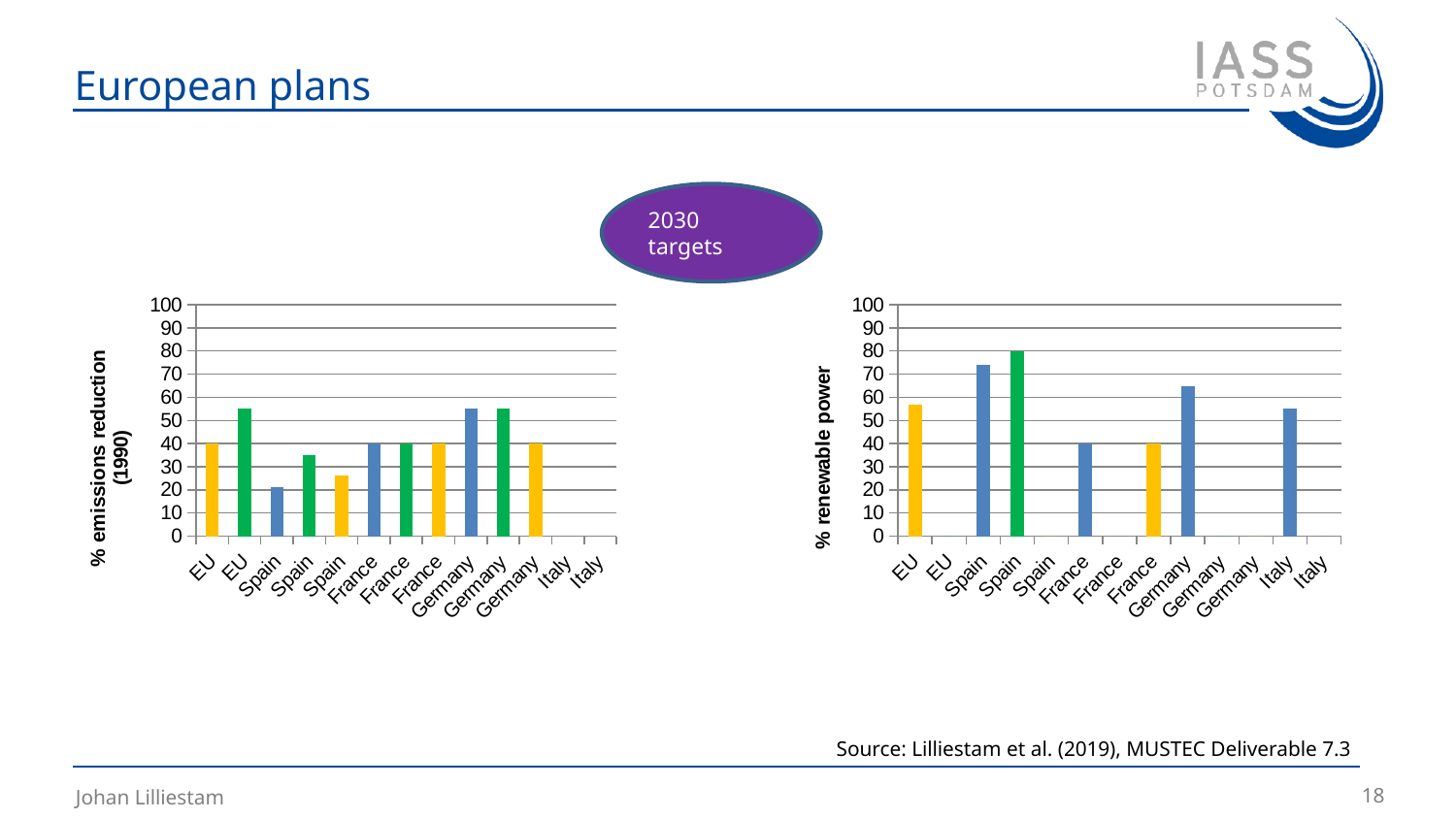
What kind of chart is the left chart titled '% emissions reduction (1990)'? bar chart In the left chart (% emissions reduction), is the value of the first Spain bar greater or less than 30? less In the left chart (% emissions reduction), which bar is taller: the first Spain bar or the second Spain bar? the second Spain bar In the right chart (% renewable power), is the value of the Germany bar greater or less than 60? greater What is the y-axis title of the left chart? % emissions reduction (1990) In the right chart (% renewable power), which bar is taller: the Germany bar or the Italy bar? Germany How many bars are plotted in the right chart (% renewable power)? 7 In the right chart (% renewable power), which category has the tallest bar? Spain In the right chart (% renewable power), is the value of the Italy bar greater or less than 50? greater In the left chart (% emissions reduction), which category has the shortest plotted bar? Spain What kind of chart is the right chart titled '% renewable power'? bar chart